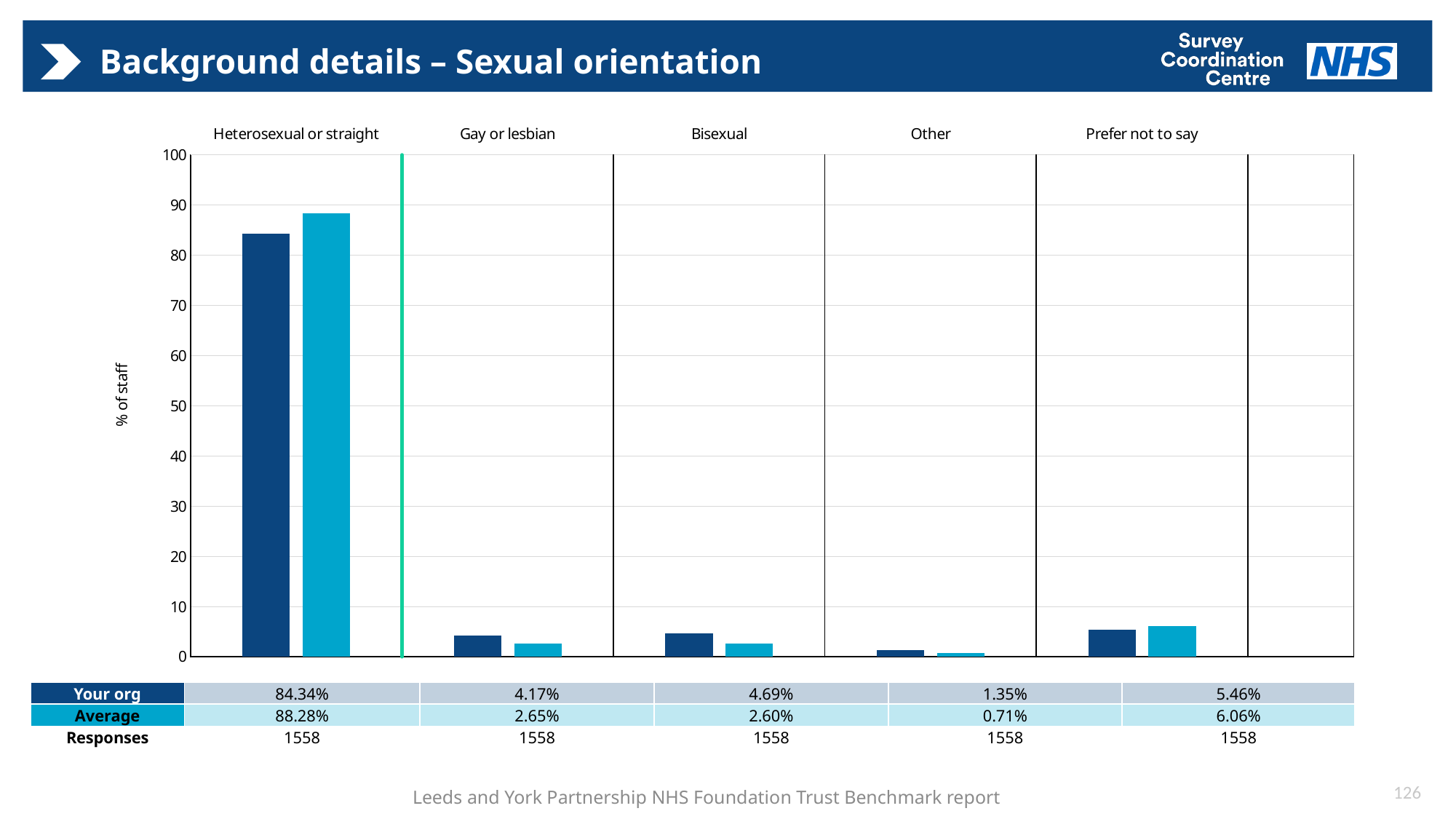
Is the 'Your org' value for Heterosexual or straight greater or less than 80? greater Which category has the lowest Average value? Other How many sexual orientation categories are shown on the chart? 5 What type of chart is shown on the slide? Bar chart What is the difference between the Average and 'Your org' values for Heterosexual or straight? 3.94% How many responses are recorded for the Other category? 1558 What is the 'Your org' value for Prefer not to say? 5.46% What is the 'Your org' value for Heterosexual or straight? 84.34% For Bisexual, which is larger: the 'Your org' value or the Average value? Your org What is the Average value for Gay or lesbian? 2.65% How many series are shown in the chart? 2 Which category has the highest 'Your org' value? Heterosexual or straight